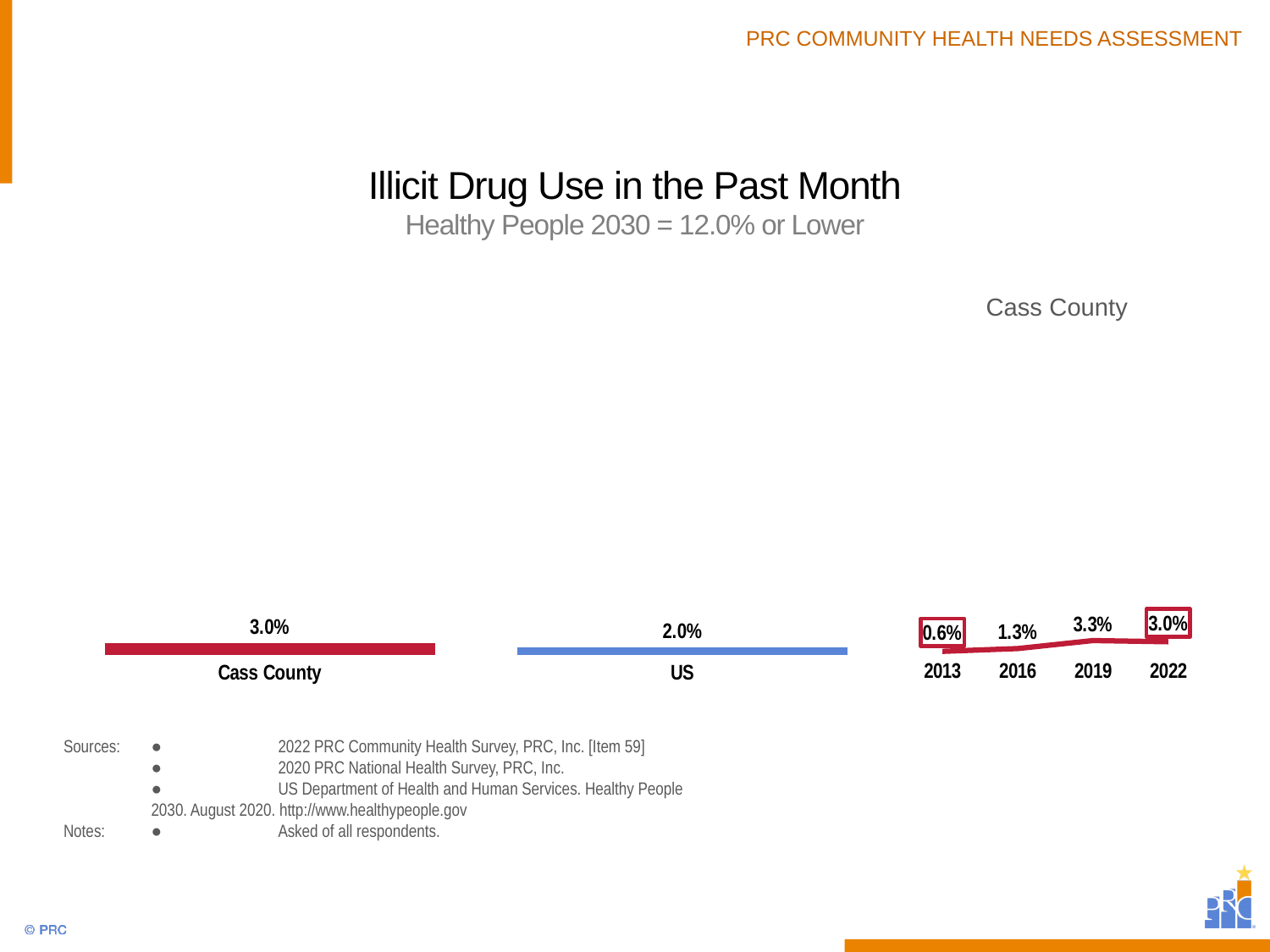
What kind of chart is the chart on the left of the slide? Bar chart In the bar chart on the left, which category has the higher value, Cass County or US? Cass County In the Cass County trend chart on the right, what is the value for 2019? 3.3% In the bar chart on the left, what is the difference between the Cass County and US values? 1.0% In the Cass County trend chart on the right, which year has the highest value? 2019 In the bar chart on the left, what is the value for US? 2.0% In the Cass County trend chart on the right, which year has the lowest value? 2013 In the Cass County trend chart on the right, what is the difference between the 2016 and 2022 values? 1.7% In the bar chart on the left, what is the value for Cass County? 3.0% In the bar chart on the left, how many categories are shown? 2 In the Cass County trend chart on the right, what is the value for 2013? 0.6% In the Cass County trend chart on the right, how many years are plotted? 4